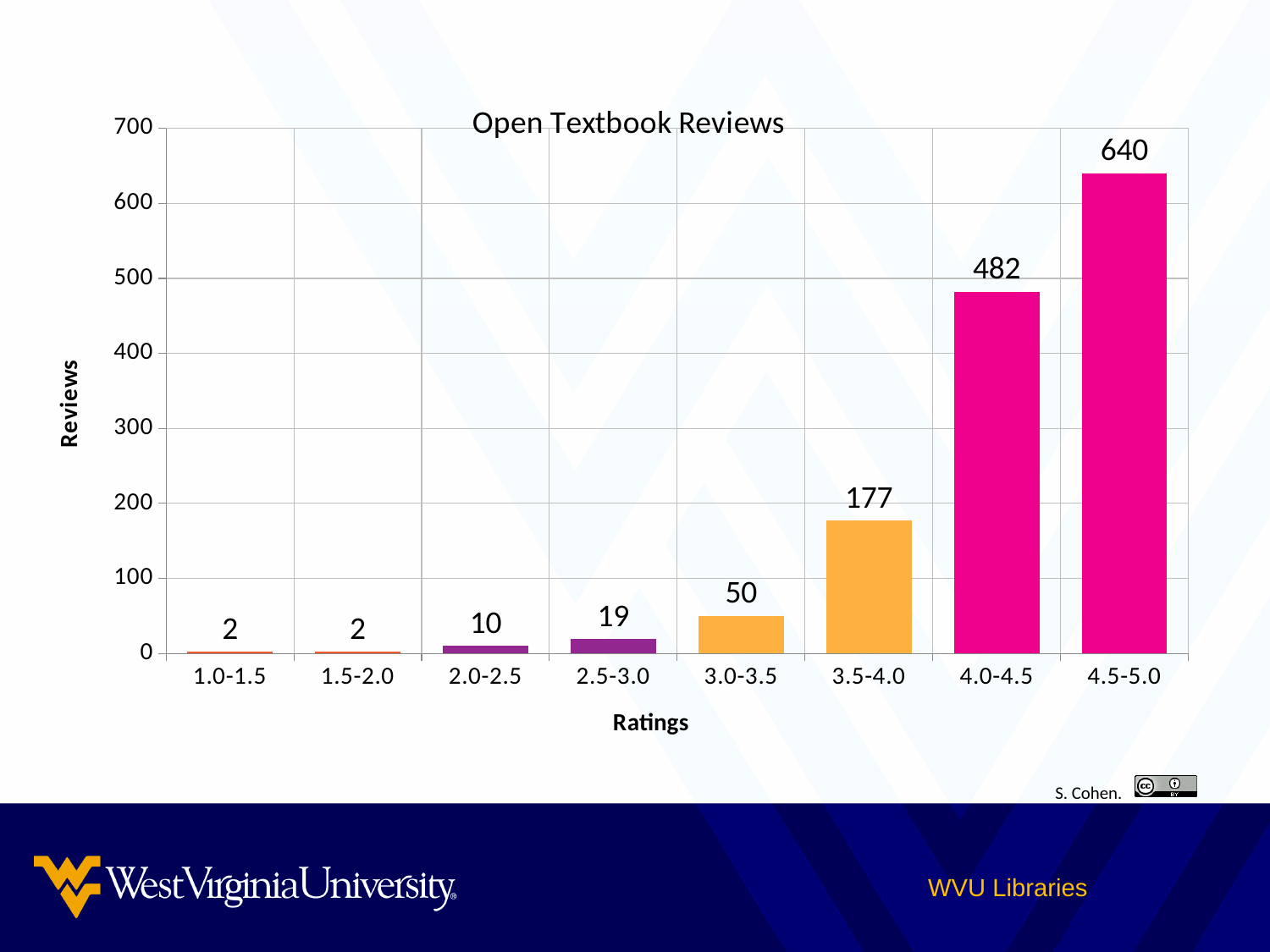
What is the title of the chart? Open Textbook Reviews What kind of chart is shown on the slide? Bar chart How many reviews are in the 4.5-5.0 rating range? 640 Which rating range has the highest number of reviews? 4.5-5.0 Do the review counts rise or fall as the rating ranges increase along the x axis? Rise How many rating ranges are shown on the x axis? 8 Which has more reviews, the 2.0-2.5 range or the 3.0-3.5 range? 3.0-3.5 What is the difference in reviews between the 3.5-4.0 and 3.0-3.5 rating ranges? 127 Is the number of reviews for the 4.0-4.5 range greater or less than 400? greater What is the number of reviews for the 3.5-4.0 rating range? 177 How many reviews fall in the 2.5-3.0 rating range? 19 What is the difference in reviews between the 4.5-5.0 and 4.0-4.5 rating ranges? 158